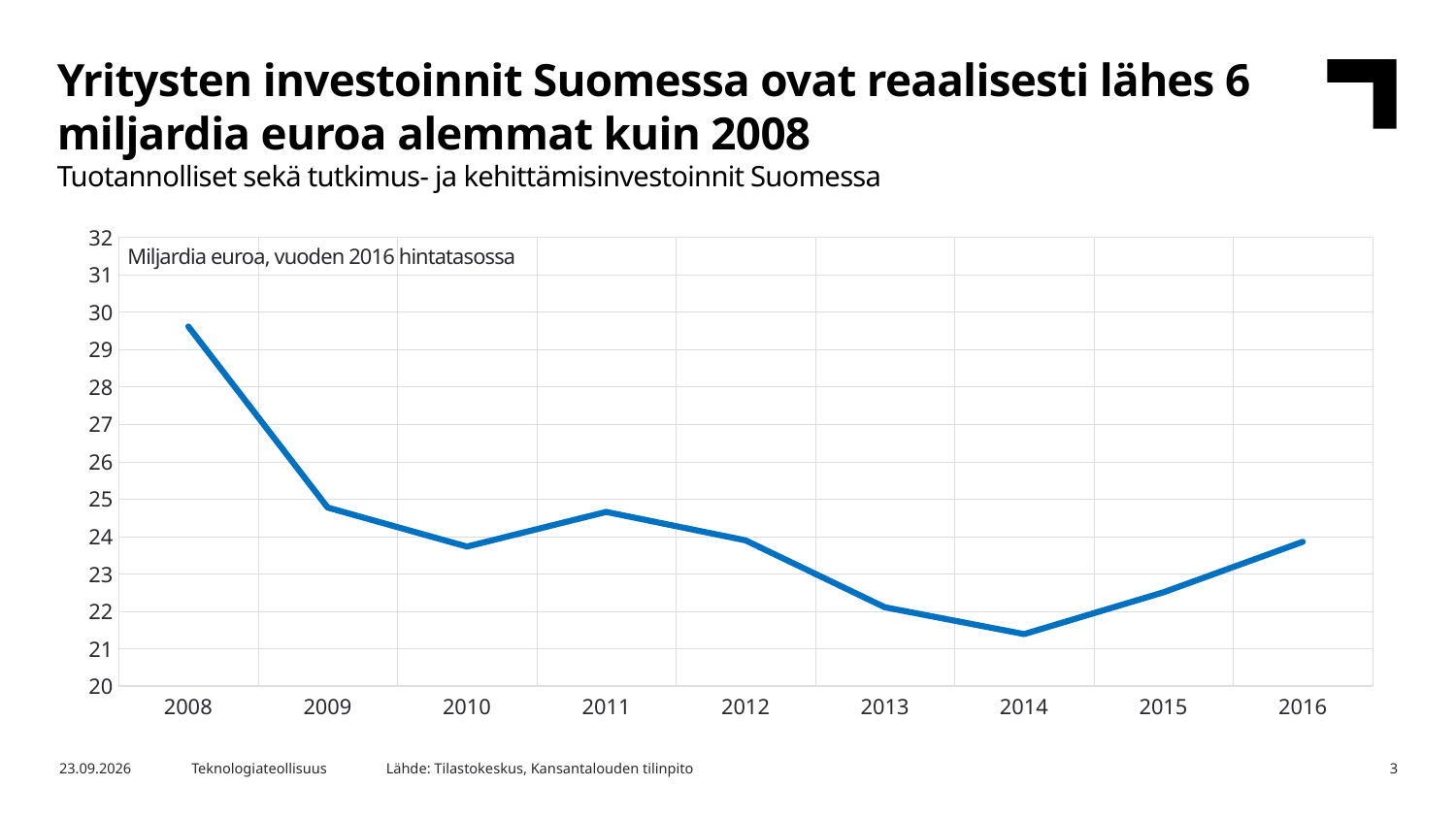
What kind of chart is shown on the slide? Line chart Is the value for 2014 greater or less than 22? less In which year is the value of investments highest? 2008 Is the value for 2010 greater or less than 24? less What unit label is shown inside the chart area? Miljardia euroa, vuoden 2016 hintatasossa In which year is the value of investments lowest? 2014 Do the values rise or fall from 2014 to 2016? rise Which year has the larger value, 2010 or 2011? 2011 How many years are plotted on the x axis of the chart? 9 Which year has the larger value, 2008 or 2016? 2008 Is the value for 2013 greater or less than 23? less